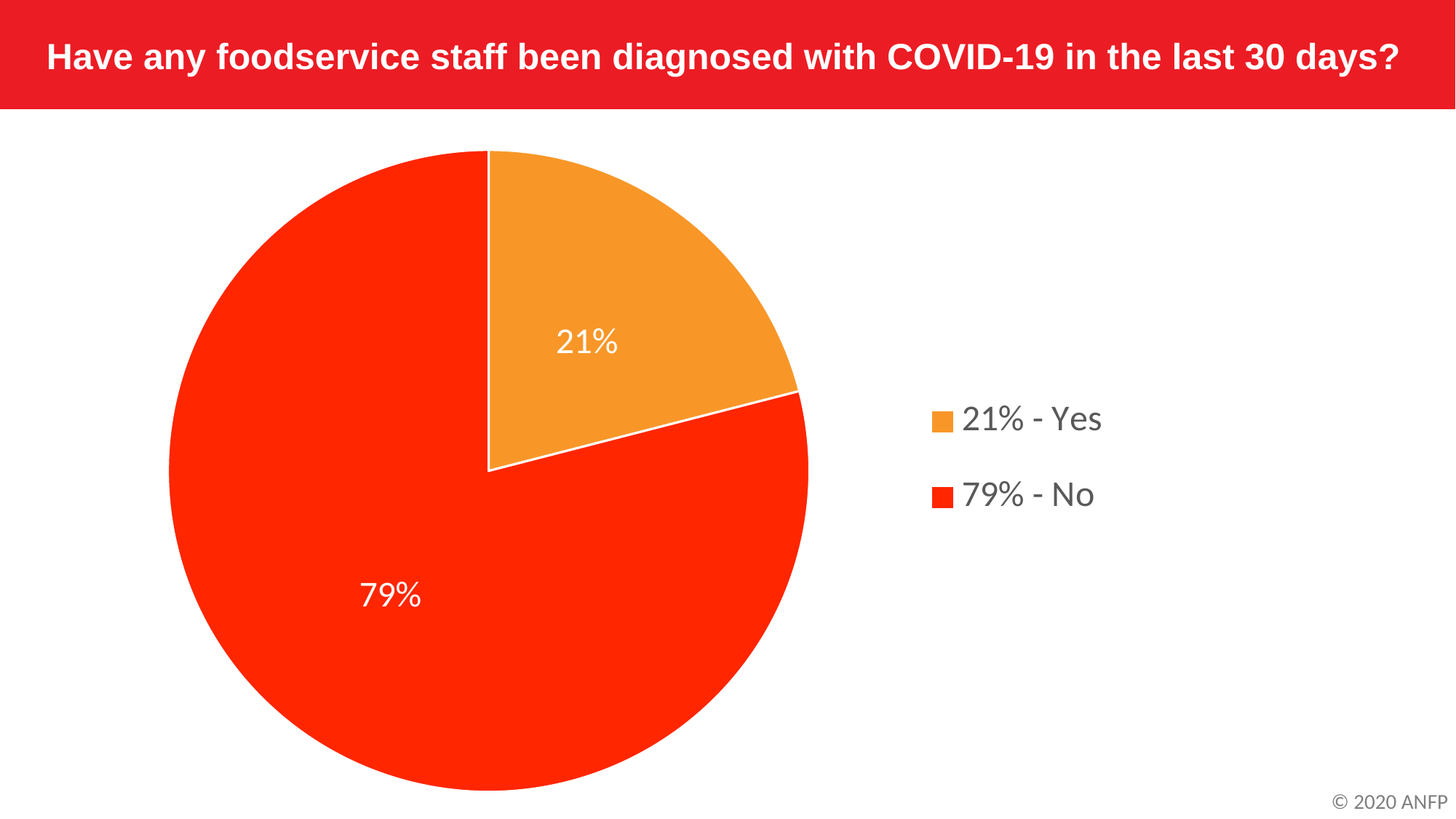
What kind of chart is shown on the slide? pie chart Which response has the largest share of the pie? No What percentage of respondents answered Yes? 21% What share of the pie does the Yes slice represent? 21% Which is larger, the Yes slice or the No slice? No What is the difference in percentage points between the No and Yes slices? 58 What percentage of respondents answered No? 79% What question does the chart title ask? Have any foodservice staff been diagnosed with COVID-19 in the last 30 days? What colour is the No slice? red How many entries does the legend list? 2 How many slices does the pie chart have? 2 Which response has the smallest share of the pie? Yes